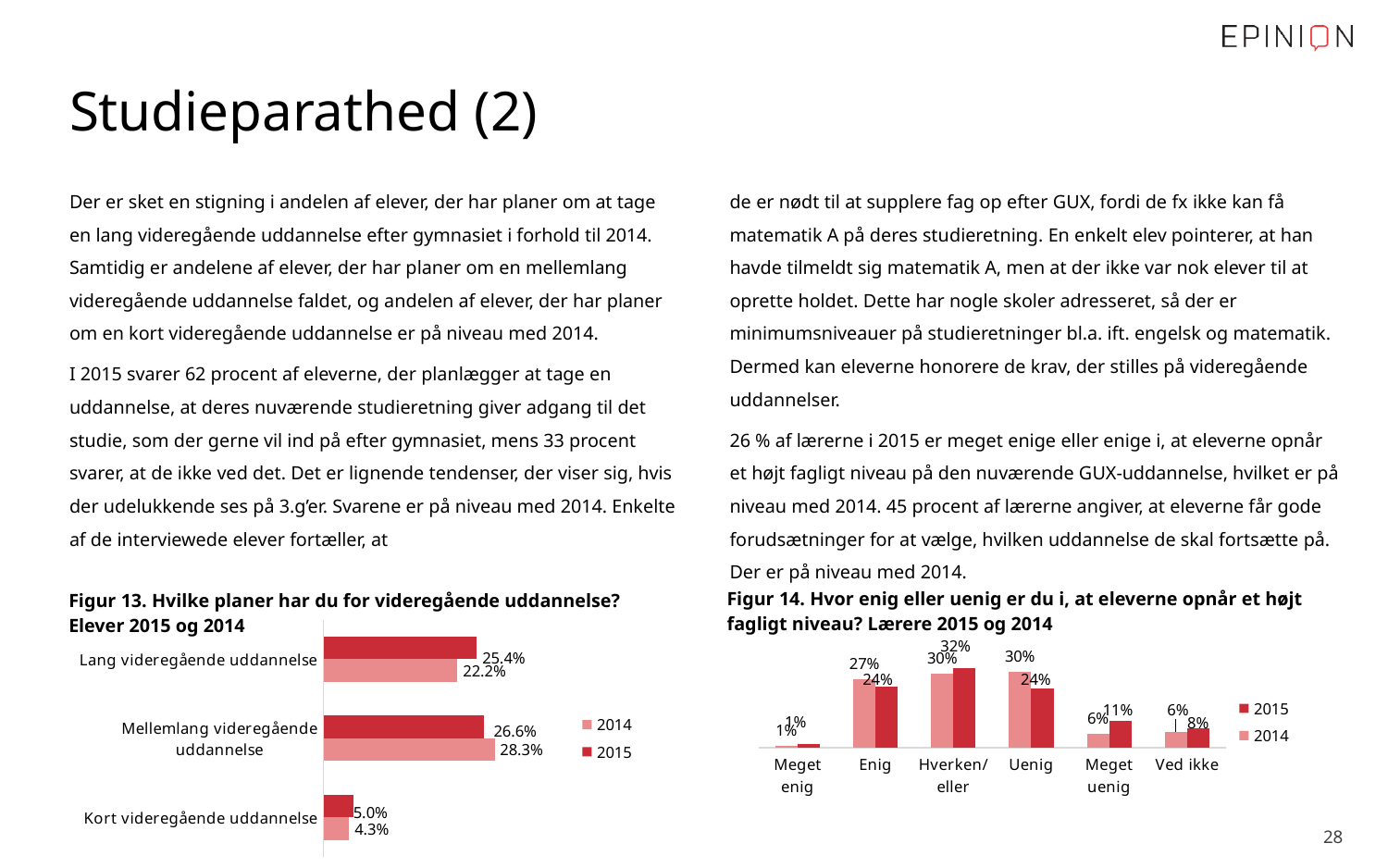
In Figur 13, what is the difference between the 2015 and 2014 values for Lang videregående uddannelse? 3.2 percentage points In Figur 13, is the 2014 value for Kort videregående uddannelse larger or smaller than the 2015 value? smaller What type of chart is Figur 13? Bar chart In Figur 13, what is the 2014 value for Mellemlang videregående uddannelse? 28.3% In Figur 14, which category has the highest 2015 value? Hverken/eller In Figur 13, what is the 2015 value for Lang videregående uddannelse? 25.4% How many series does the legend of Figur 14 list? 2 In Figur 14, what is the 2014 value for Uenig? 30% In Figur 14, what is the 2015 value for Hverken/eller? 32% In Figur 13, how many categories are shown? 3 In Figur 14, what is the difference between the 2015 and 2014 values for Meget uenig? 5 percentage points In Figur 13, which category has the lowest 2015 value? Kort videregående uddannelse